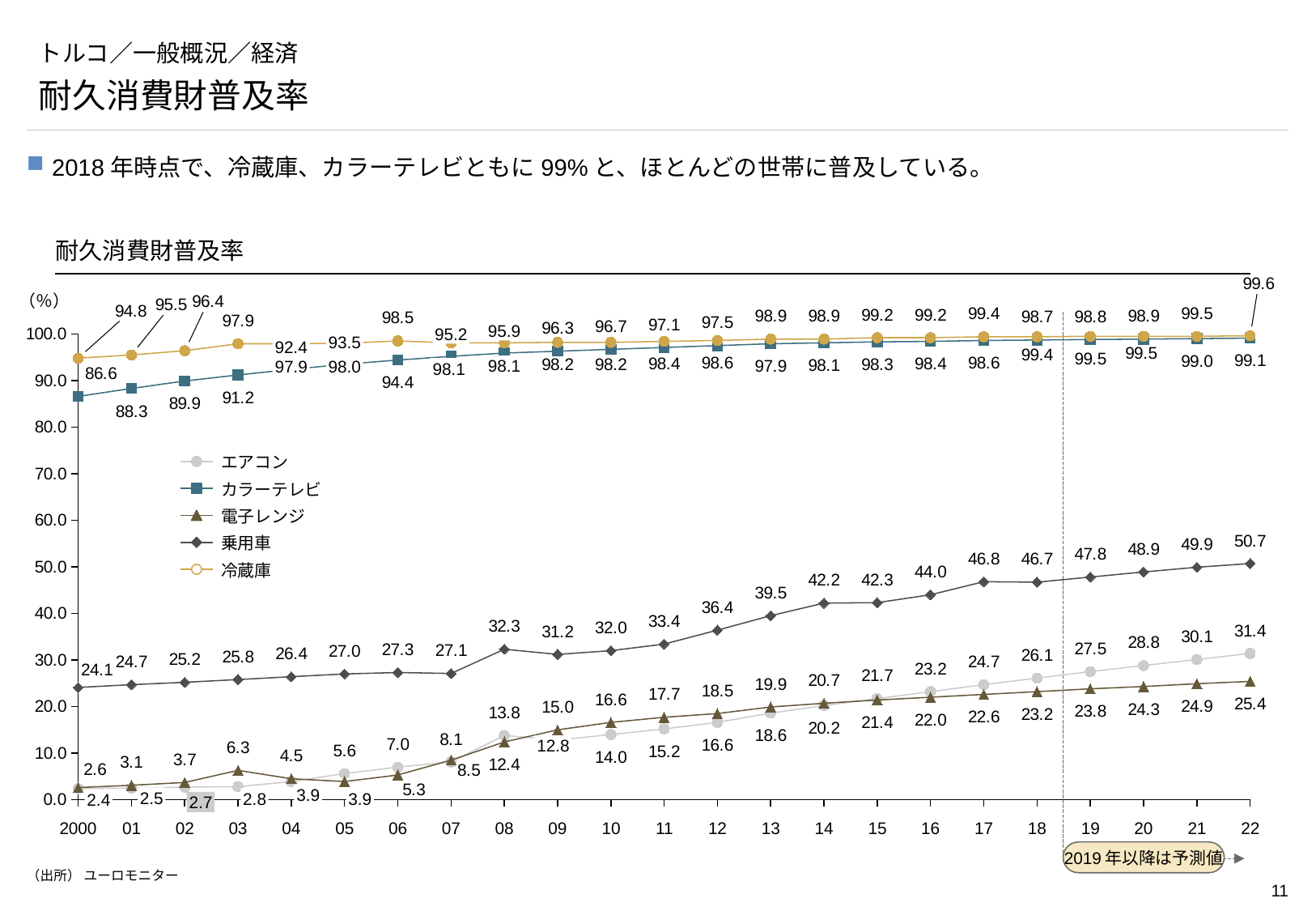
What is the value for カラーテレビ in 2000? 86.6 What is the value for 乗用車 in 22? 50.7 Does the 乗用車 line rise or fall from 2000 to 22? rise What is the difference between the 乗用車 value in 22 and in 2000? 26.6 In 22, which is larger, エアコン or 電子レンジ? エアコン How many years (data points) are plotted along the x axis? 23 What is the value for エアコン in 22? 31.4 Which series has the lowest value in 2000? エアコン What is the value for 冷蔵庫 in 2000? 94.8 How many series does the legend list? 5 What kind of chart is shown on the slide? line chart What is the value for 電子レンジ in 22? 25.4